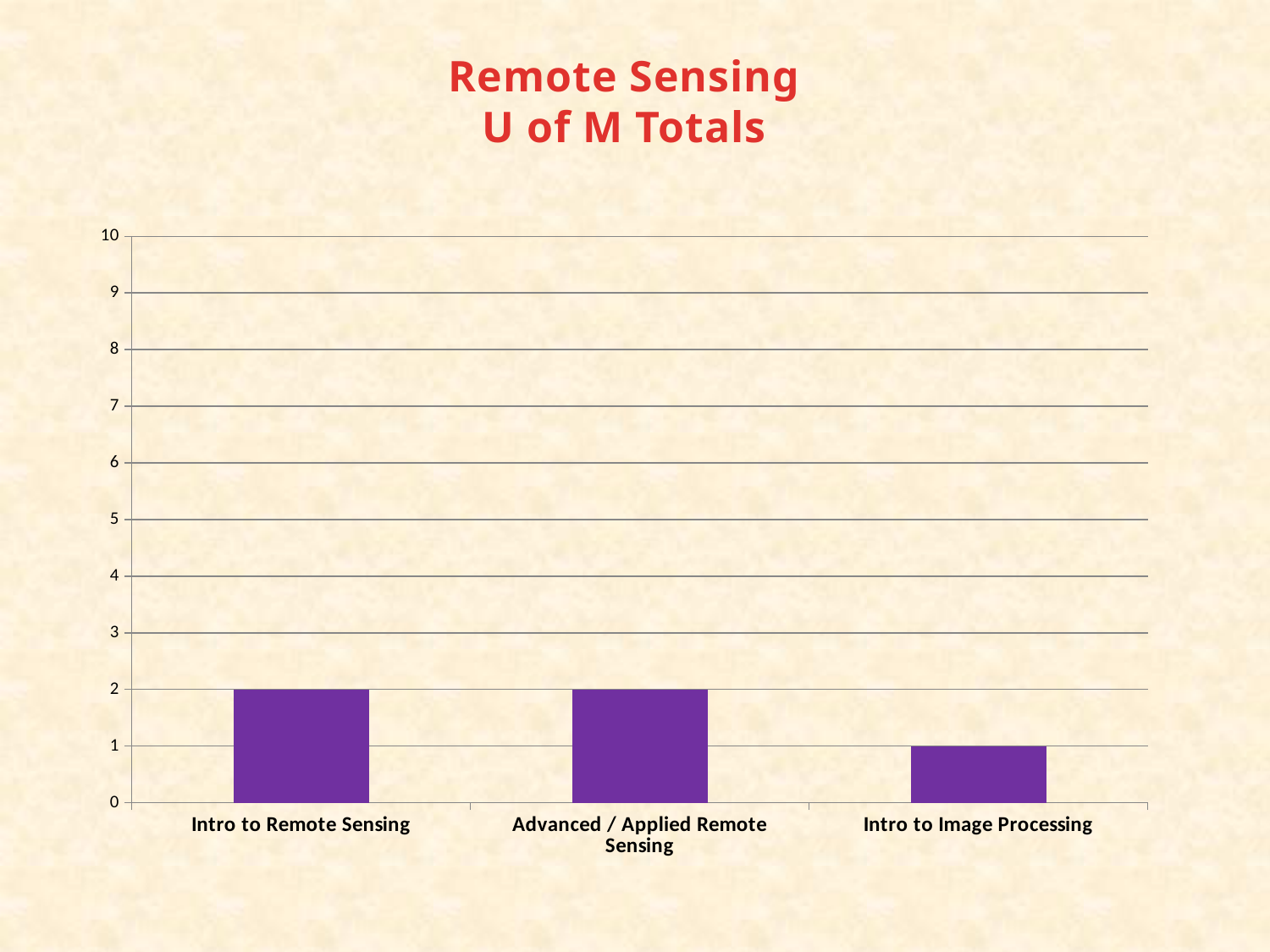
Is the value for Intro to Remote Sensing greater or less than 8? less What is the value for Advanced / Applied Remote Sensing? 2 What is the difference between the values for Intro to Remote Sensing and Intro to Image Processing? 1 What is the title of the chart? Remote Sensing U of M Totals What is the value for Intro to Image Processing? 1 Which category has the lowest value? Intro to Image Processing What is the value for Intro to Remote Sensing? 2 How many categories are shown on the x axis? 3 Is the value for Intro to Image Processing greater or less than 5? less What is the highest value shown on the y axis? 10 What kind of chart is shown on the slide? bar chart Which is larger, the value for Advanced / Applied Remote Sensing or the value for Intro to Image Processing? Advanced / Applied Remote Sensing